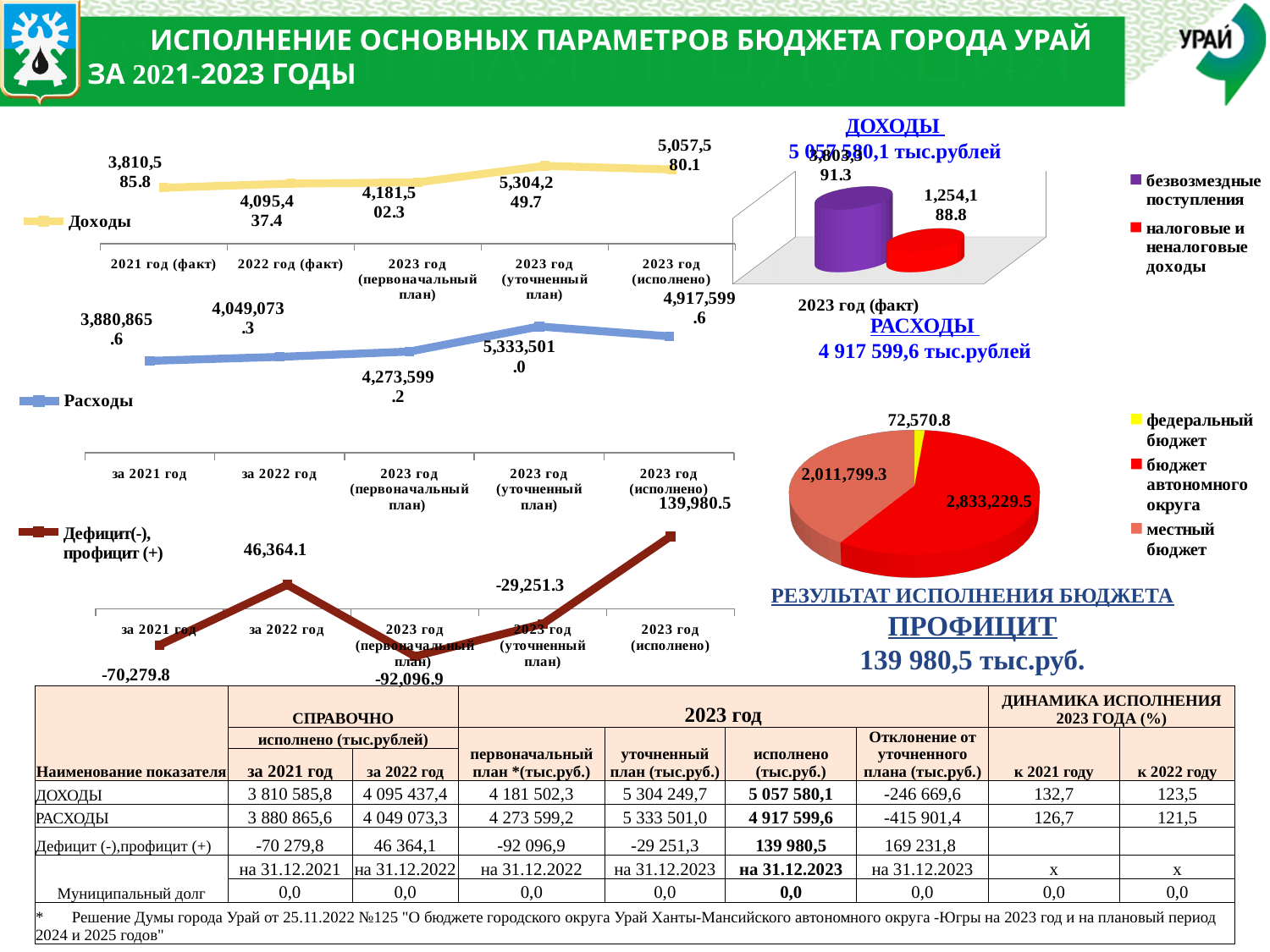
In the Дефицит(-), профицит (+) line chart, what is the value for за 2022 год? 46,364.1 What kind of chart is the РАСХОДЫ chart? pie chart In the Дефицит(-), профицит (+) line chart, which category has the lowest value? 2023 год (первоначальный план) In the Дефицит(-), профицит (+) line chart, how many data points are plotted? 5 In the РАСХОДЫ pie chart, which category has the largest slice? бюджет автономного округа In the Дефицит(-), профицит (+) line chart, what is the value for 2023 год (исполнено)? 139,980.5 How many entries does the legend of the РАСХОДЫ pie chart list? 3 In the РАСХОДЫ pie chart, what is the value for федеральный бюджет? 72,570.8 In the ДОХОДЫ chart, which is larger: безвозмездные поступления or налоговые и неналоговые доходы? безвозмездные поступления In the Расходы line chart, which is larger: the value for 2023 год (уточненный план) or the value for 2023 год (исполнено)? 2023 год (уточненный план) In the Дефицит(-), профицит (+) line chart, what is the difference between the value for 2023 год (исполнено) and the value for за 2022 год? 93,616.4 What kind of chart is the Доходы chart at the top left of the slide? line chart